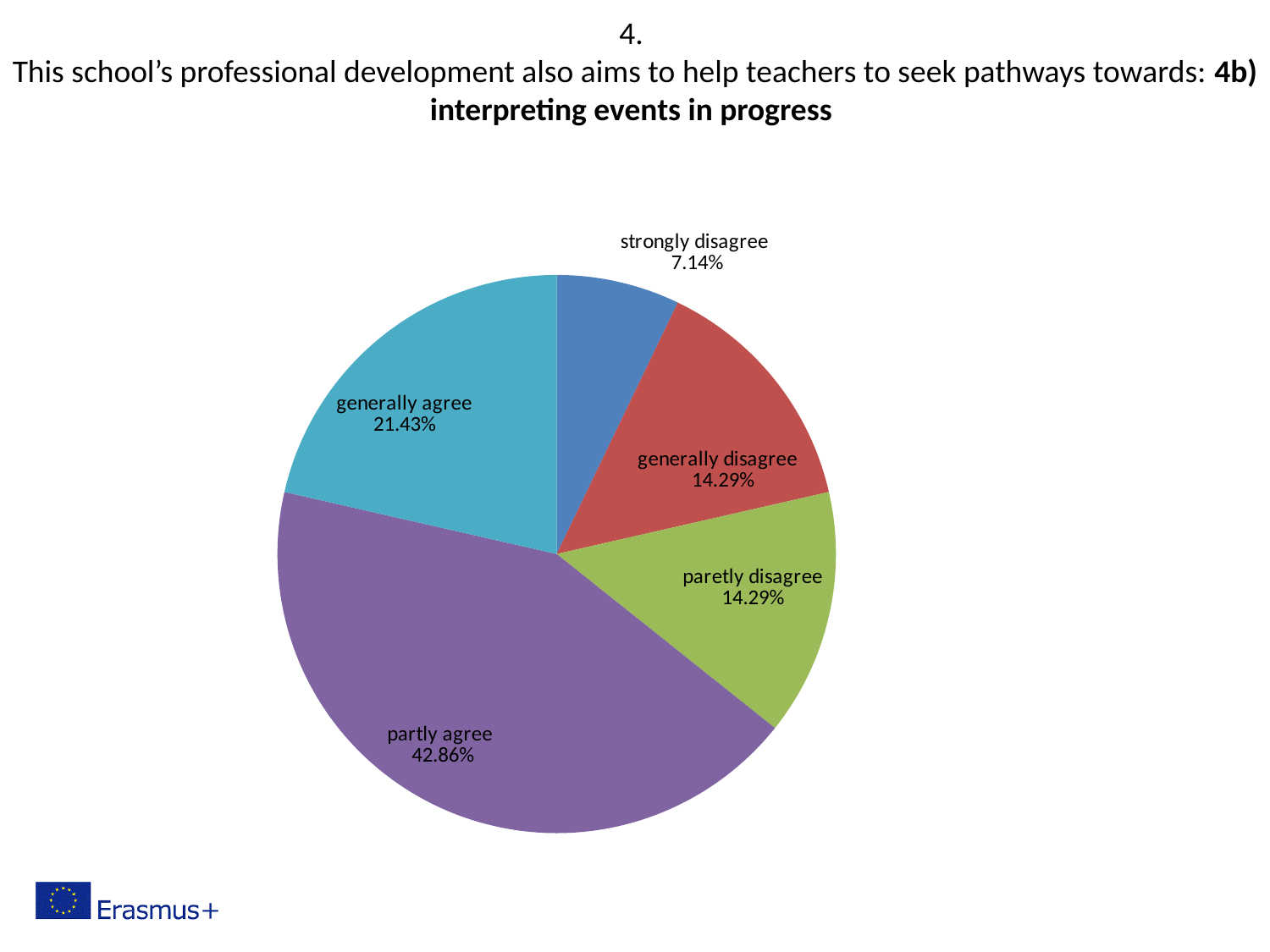
What is the difference between the shares for "partly agree" and "generally agree"? 21.43% What is the value shown for "generally agree"? 21.43% Which category has the largest slice of the pie? partly agree How many slices does the pie chart have? 5 What colour is the "partly agree" slice? purple What share of the pie does "partly agree" have? 42.86% Which category has the smallest slice of the pie? strongly disagree What is the value shown for "generally disagree"? 14.29% Which is larger, the share for "generally agree" or the share for "strongly disagree"? generally agree What is the value shown for "strongly disagree"? 7.14% What kind of chart is shown on the slide? pie chart What is the combined share of "generally disagree" and "paretly disagree"? 28.58%